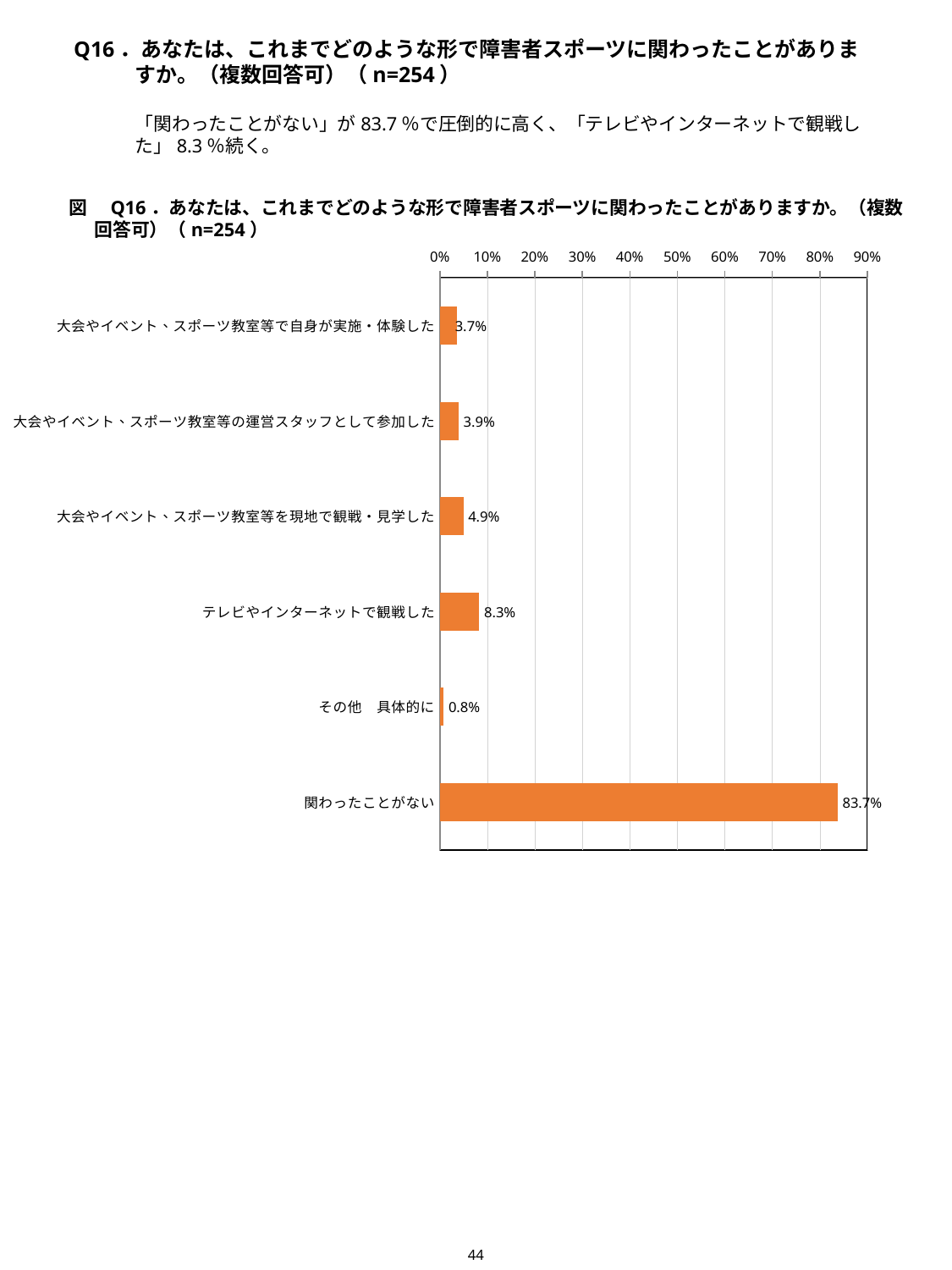
What kind of chart is shown on the slide? bar chart What is the difference between 関わったことがない and テレビやインターネットで観戦した? 75.4% How many categories are shown in the chart? 6 What is the sample size (n) stated in the chart title? 254 What is the value for 関わったことがない? 83.7% What is the value for テレビやインターネットで観戦した? 8.3% Which category has the highest value? 関わったことがない What is the value for その他 具体的に? 0.8% Which category has the lowest value? その他 具体的に What is the value for 大会やイベント、スポーツ教室等を現地で観戦・見学した? 4.9% Is the value for 関わったことがない greater or less than 80%? greater Which is larger: 大会やイベント、スポーツ教室等を現地で観戦・見学した or 大会やイベント、スポーツ教室等で自身が実施・体験した? 大会やイベント、スポーツ教室等を現地で観戦・見学した